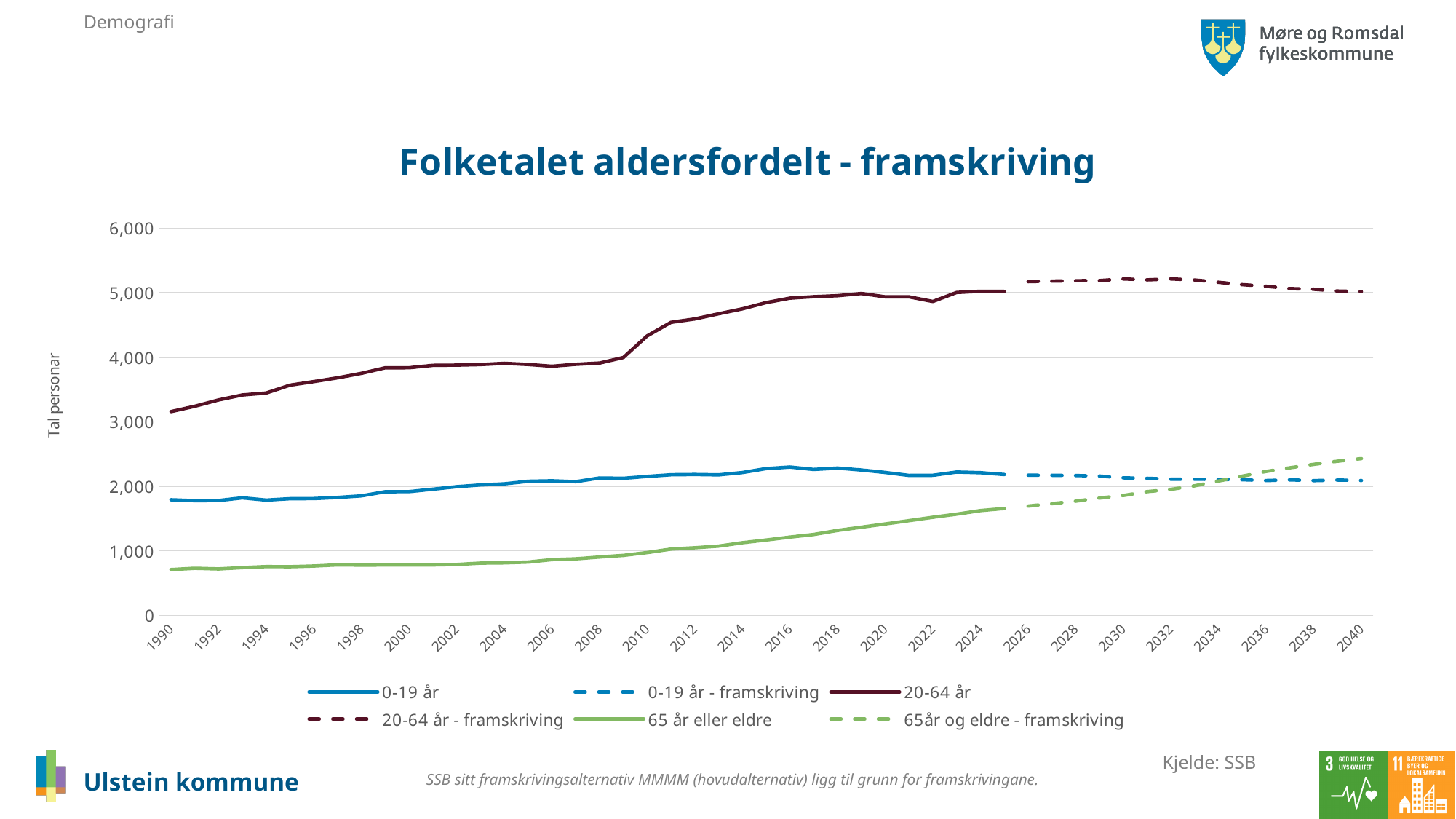
Does the 65 år eller eldre series rise or fall from 1990 to 2024? rise How many series does the legend list? 6 Is the value for 20-64 år - framskriving in 2030 greater or less than 5,000? greater Is the value for 0-19 år in 2016 greater or less than 2,000? greater What is the label on the vertical axis of the chart? Tal personar Is the value for 65år og eldre - framskriving in 2040 greater or less than 2,000? greater In 2024, which is larger: 0-19 år or 65 år eller eldre? 0-19 år What is the title of the chart? Folketalet aldersfordelt - framskriving What kind of chart is shown on the slide? line chart Which age group series has the highest values across the whole chart? 20-64 år